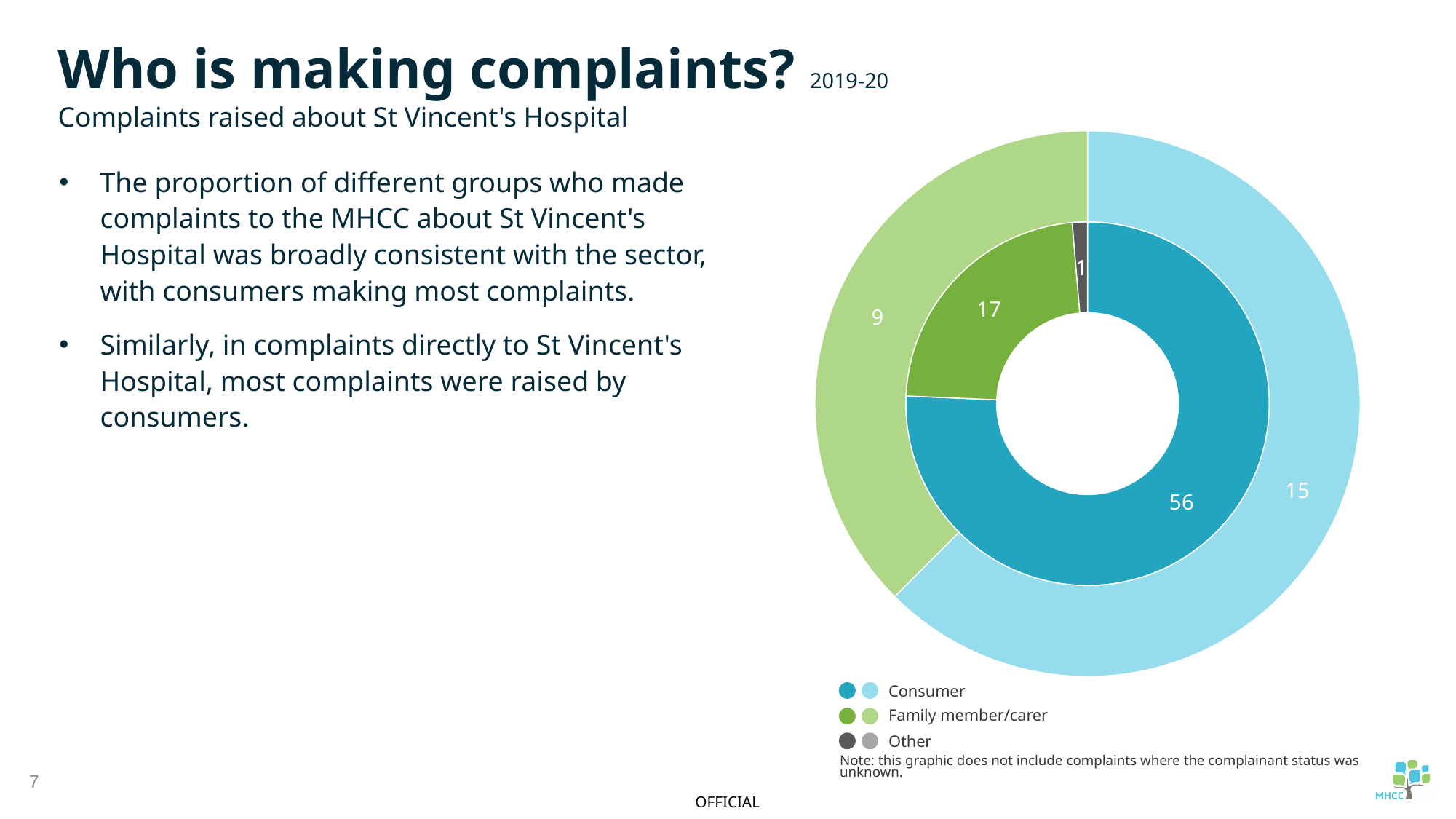
In the inner ring of the doughnut chart, what is the value for Consumer? 56 In the inner ring of the doughnut chart, what is the value for Family member/carer? 17 In the inner ring, what is the difference between the Consumer value and the Family member/carer value? 39 What is the subtitle shown under the slide title? Complaints raised about St Vincent's Hospital How many groups does the legend of the doughnut chart list? 3 In the inner ring of the doughnut chart, what is the value for Other? 1 Which group has the smallest value in the inner ring of the doughnut chart? Other What type of chart is shown on the slide? doughnut chart In the outer ring, what is the difference between the Consumer value and the Family member/carer value? 6 In the outer ring of the doughnut chart, what is the value for Family member/carer? 9 Which group has the largest value in the inner ring of the doughnut chart? Consumer In the outer ring of the doughnut chart, what is the value for Consumer? 15